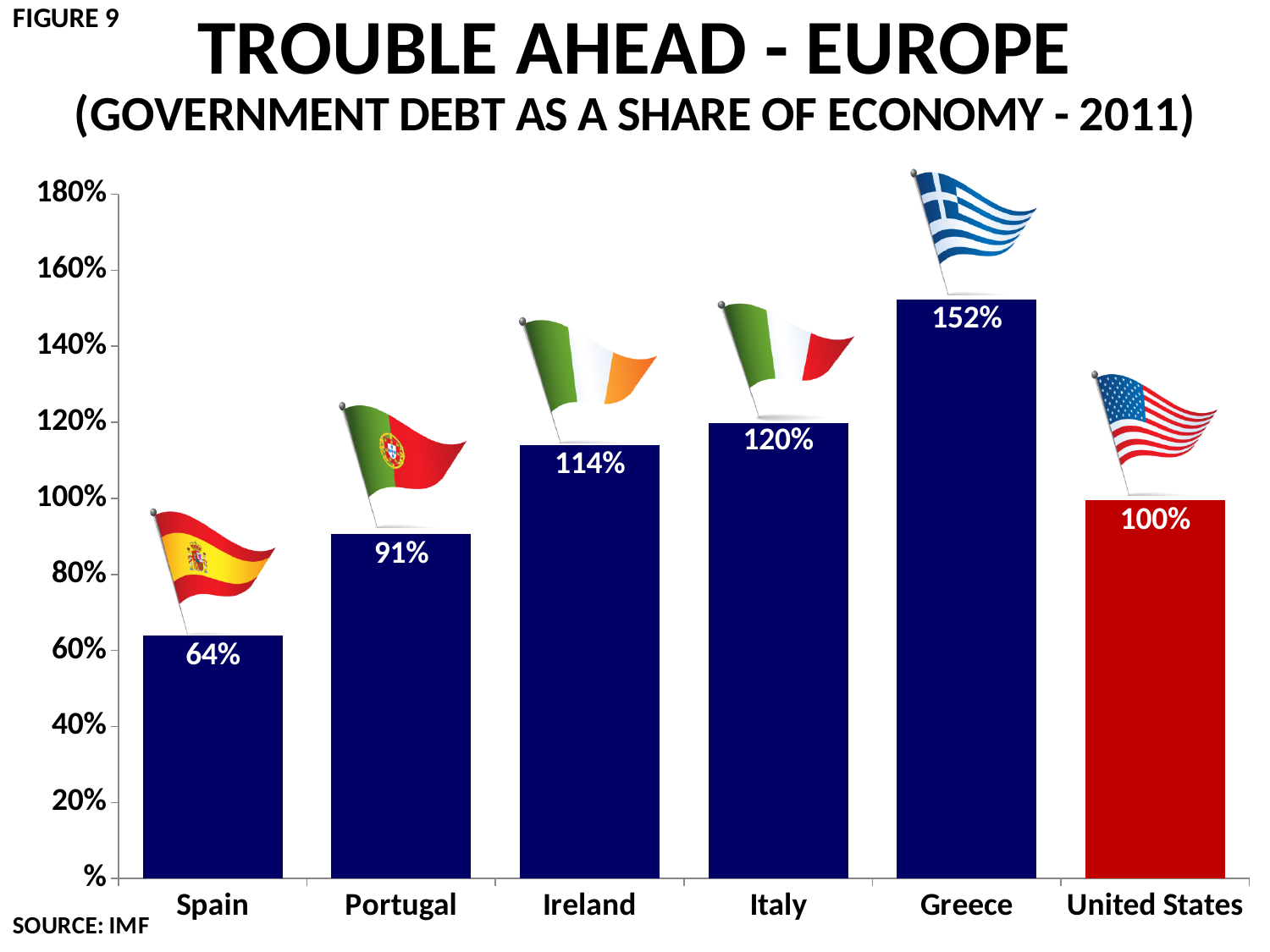
How many countries are shown in the chart? 6 What is the source cited for the chart? IMF Which country has the highest government debt as a share of economy? Greece What is the value shown for Spain? 64% Which country has the lowest government debt as a share of economy? Spain What is the difference between the values for Portugal and Spain? 27% What is the value shown for the United States? 100% Is the value for Portugal greater or less than 100%? less What kind of chart is shown on the slide? bar chart What is the difference between the values for Greece and Italy? 32% Which is larger, the value for Ireland or the value for Italy? Italy What is the government debt as a share of economy for Greece? 152%